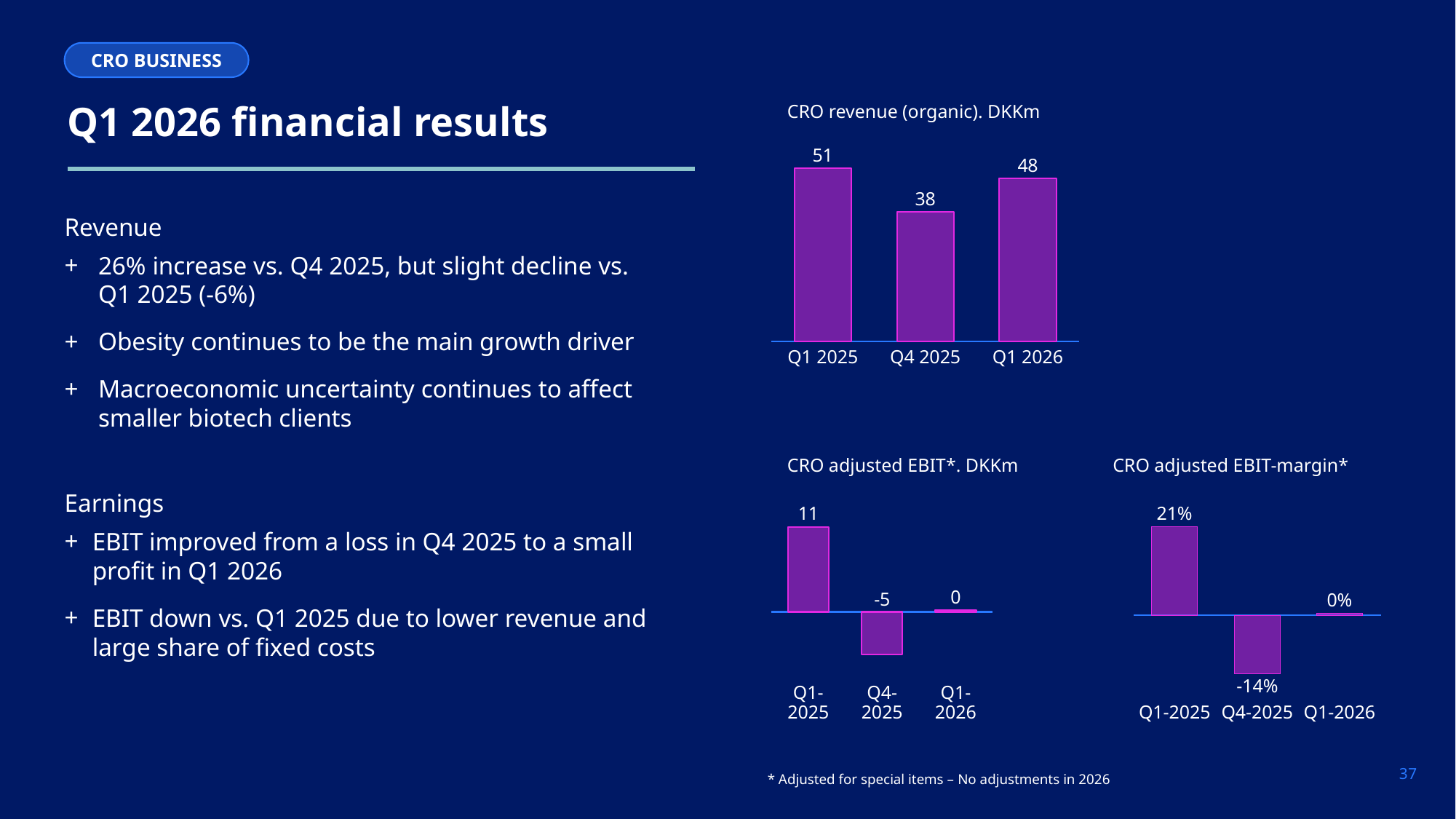
In the 'CRO adjusted EBIT*. DKKm' chart, what is the value for Q1-2025? 11 What kind of chart is the 'CRO revenue (organic). DKKm' chart? Bar chart In the 'CRO revenue (organic). DKKm' chart, what is the difference between Q1 2025 and Q1 2026? 3 In the 'CRO adjusted EBIT-margin*' chart, what is the value for Q1-2026? 0% In the 'CRO adjusted EBIT-margin*' chart, which is larger, the value for Q1-2025 or Q1-2026? Q1-2025 How many charts are shown on the slide? 3 In the 'CRO adjusted EBIT*. DKKm' chart, what is the difference between Q1-2025 and Q4-2025? 16 In the 'CRO adjusted EBIT-margin*' chart, what is the value for Q4-2025? -14% In the 'CRO revenue (organic). DKKm' chart, what is the value for Q4 2025? 38 In the 'CRO adjusted EBIT*. DKKm' chart, which quarter has the lowest value? Q4-2025 In the 'CRO revenue (organic). DKKm' chart, which quarter has the highest revenue? Q1 2025 In the 'CRO revenue (organic). DKKm' chart, how many quarters are shown? 3